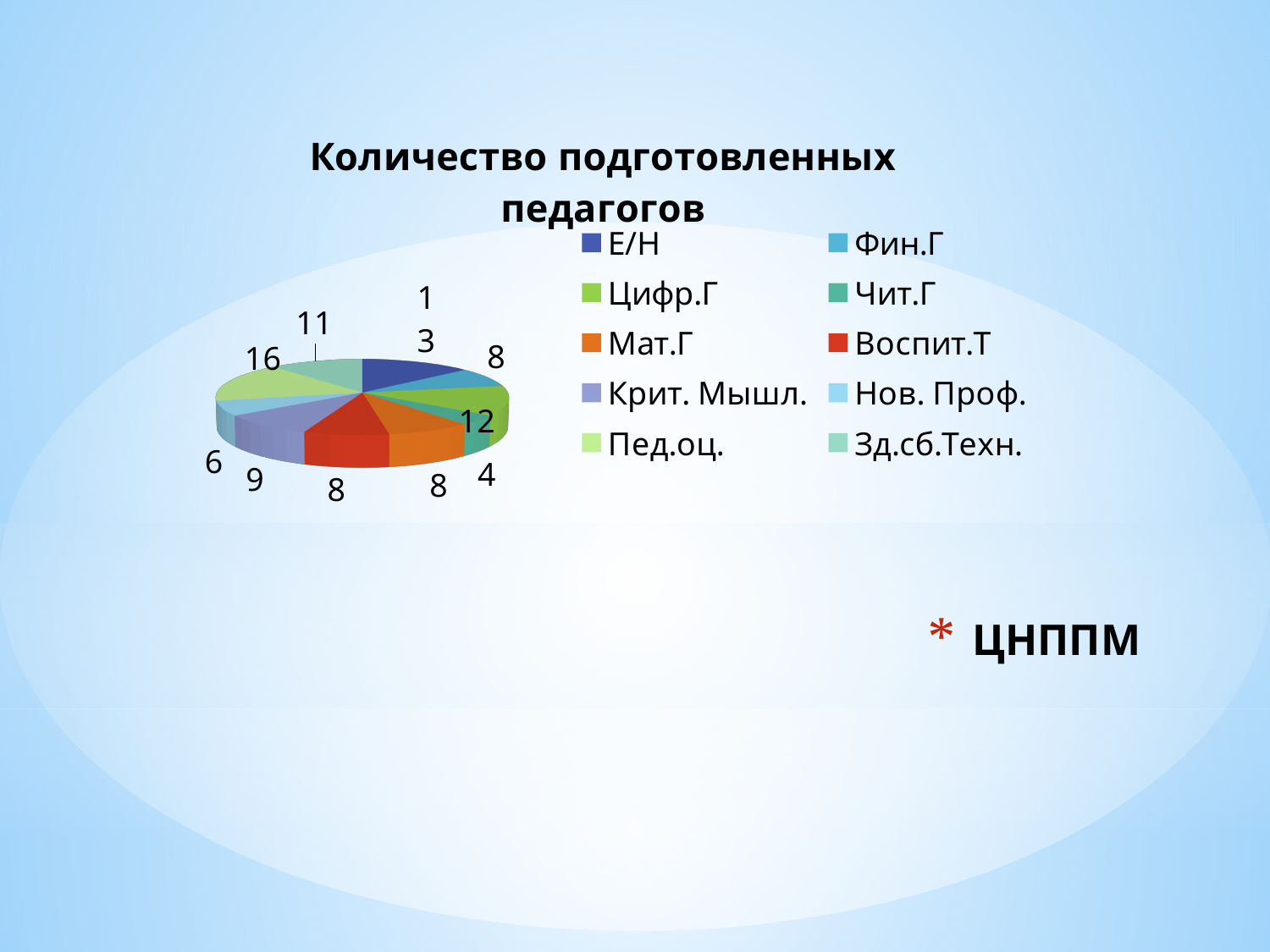
Which category has the largest slice? Пед.оц. What is the title of the chart? Количество подготовленных педагогов What is the value for Пед.оц.? 16 Which is larger, the value for Крит. Мышл. or the value for Нов. Проф.? Крит. Мышл. What is the difference between the values for Пед.оц. and Зд.сб.Техн.? 5 What is the value for Нов. Проф.? 6 What kind of chart is shown on the slide? pie chart What is the value for Зд.сб.Техн.? 11 How many categories does the legend list? 10 What is the value for Крит. Мышл.? 9 What is the value for Цифр.Г? 12 What is the value for Чит.Г? 4